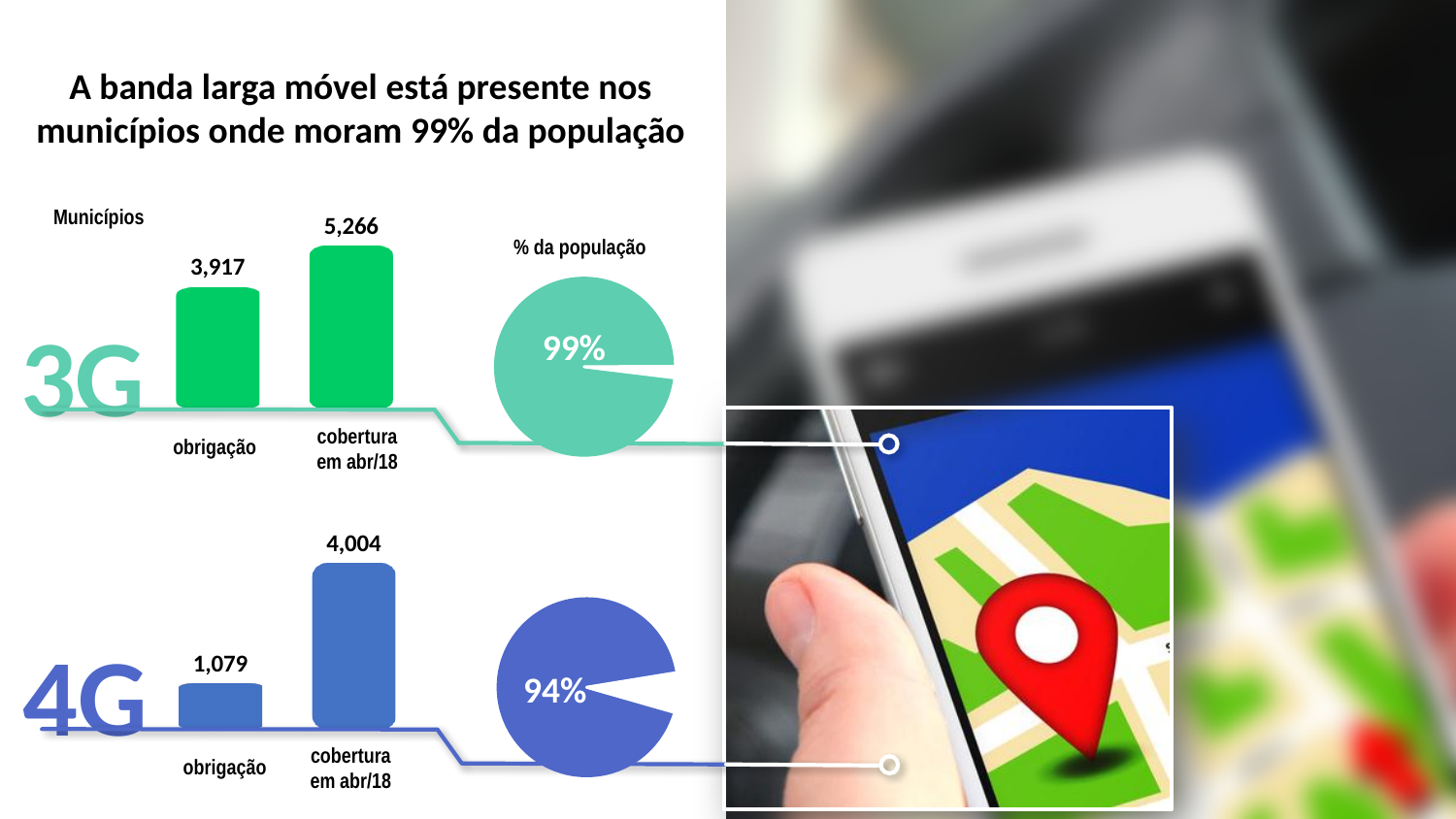
In the 3G bar chart, which category has the lowest value? obrigação In the 3G bar chart, what is the difference between cobertura em abr/18 and obrigação? 1,349 What share of the population is shown in the 3G pie chart? 99% What share of the population is shown in the 4G pie chart? 94% In the 4G bar chart, what is the value for obrigação? 1,079 In the 3G bar chart, what is the value for cobertura em abr/18? 5,266 How many categories does the 4G bar chart show? 2 In the 4G bar chart, what is the difference between cobertura em abr/18 and obrigação? 2,925 In the 4G bar chart, which category has the higher value, obrigação or cobertura em abr/18? cobertura em abr/18 In the 3G bar chart, what is the value for obrigação? 3,917 What kind of chart is used to show the % da população for 3G? pie chart In the 4G bar chart, what is the value for cobertura em abr/18? 4,004